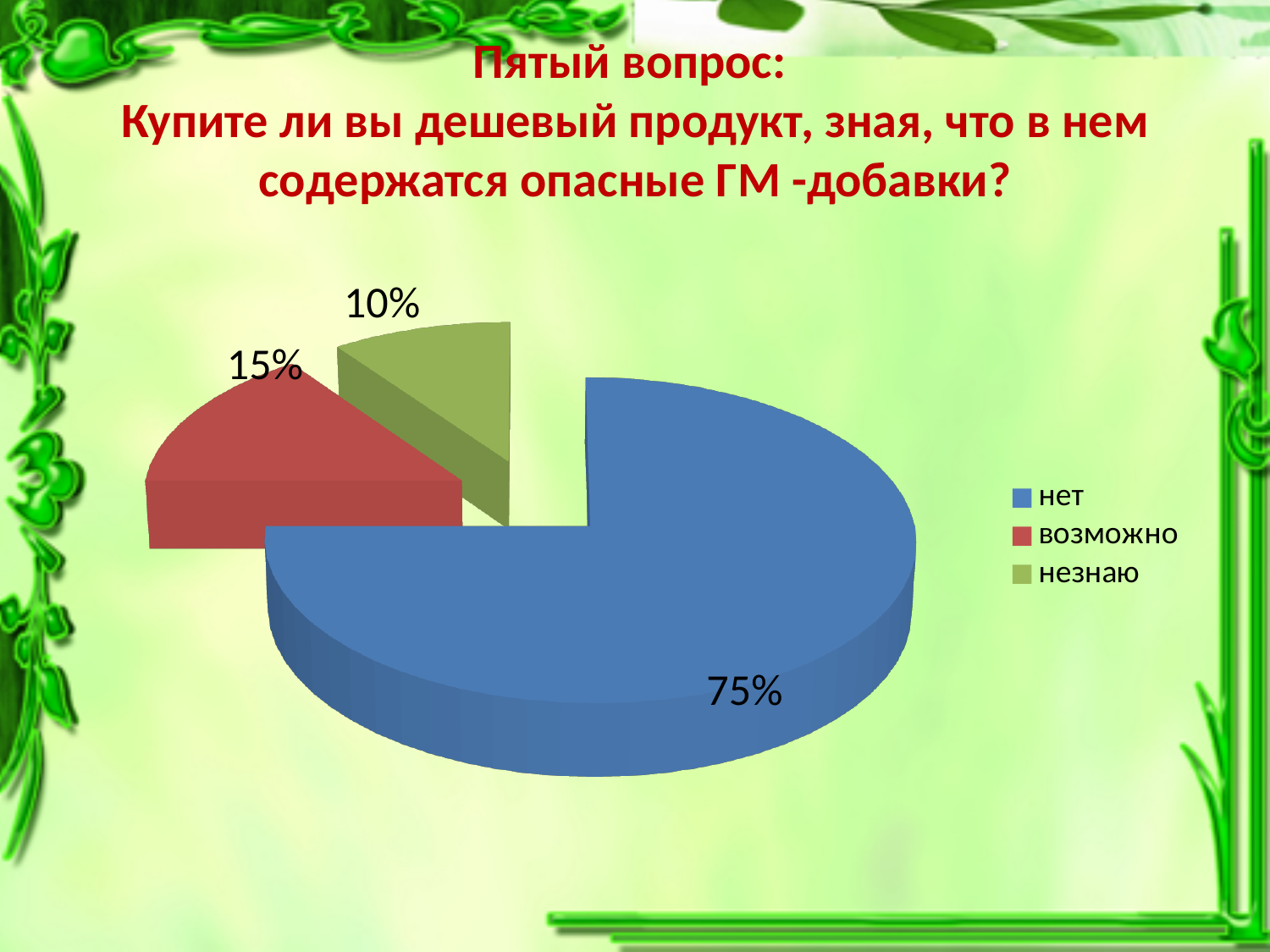
Which answer has the largest share of the pie? нет Which answer has the smallest share of the pie? незнаю Which is larger, the share for "возможно" or the share for "незнаю"? возможно How many entries does the legend list? 3 What kind of chart is shown on the slide? pie chart What percentage of respondents answered "незнаю"? 10% What percentage of respondents answered "нет"? 75% What is the difference in percentage points between "возможно" and "незнаю"? 5 What colour is the slice for "нет"? blue What percentage of respondents answered "возможно"? 15% How many slices does the pie chart have? 3 What is the difference in percentage points between "нет" and "возможно"? 60